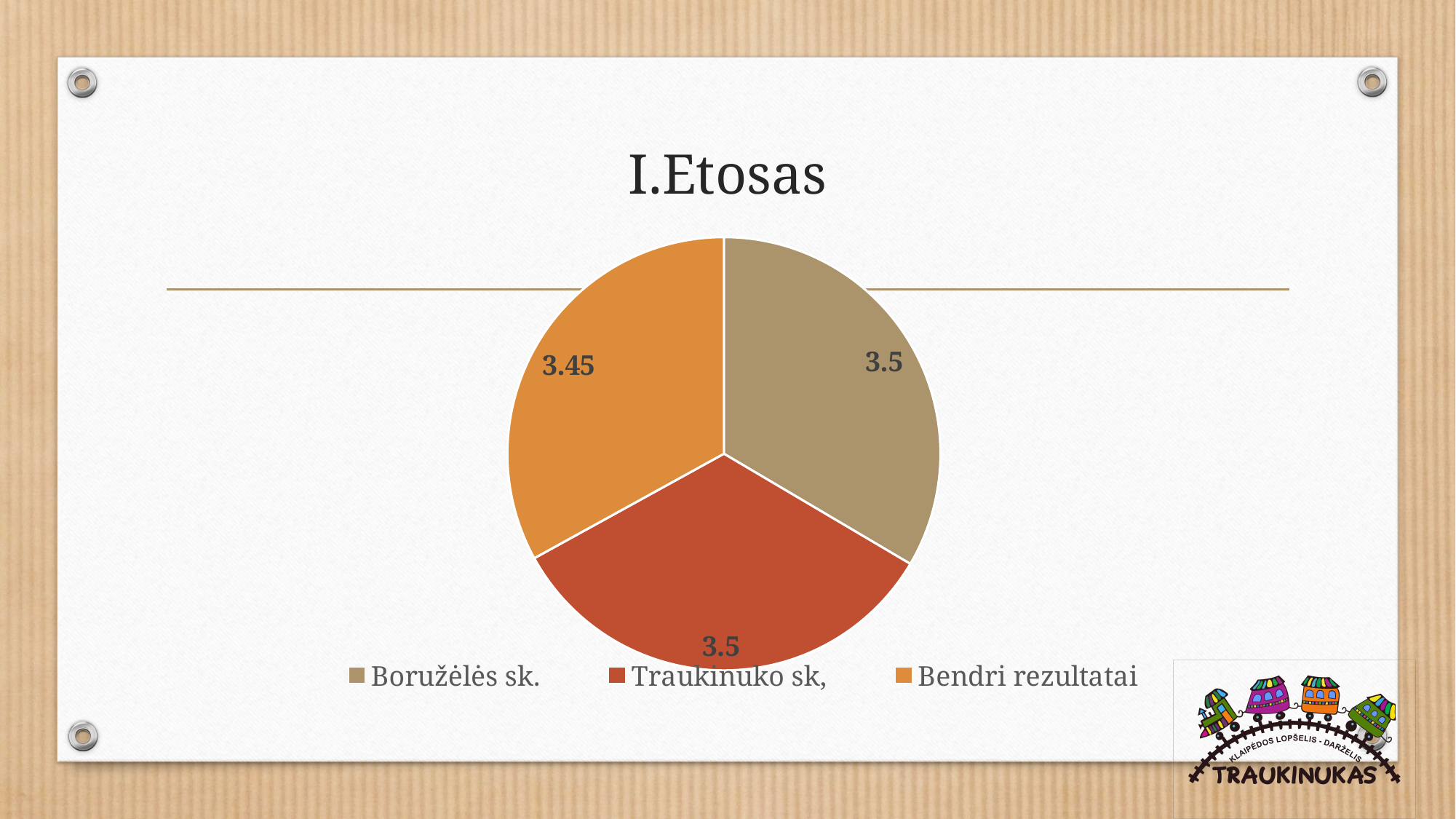
What is the difference between the value for Boružėlės sk. and the value for Bendri rezultatai? 0.05 What is the title of the chart? I.Etosas Which category has the lowest value in the pie chart? Bendri rezultatai Which is larger, the value for Traukinuko sk, or the value for Bendri rezultatai? Traukinuko sk, How many entries does the legend list? 3 How many slices does the pie chart have? 3 What is the value for Bendri rezultatai in the pie chart? 3.45 What kind of chart is shown on the slide? Pie chart What is the value for Traukinuko sk, in the pie chart? 3.5 What is the value for Boružėlės sk. in the pie chart? 3.5 Which legend entry is shown in orange? Bendri rezultatai